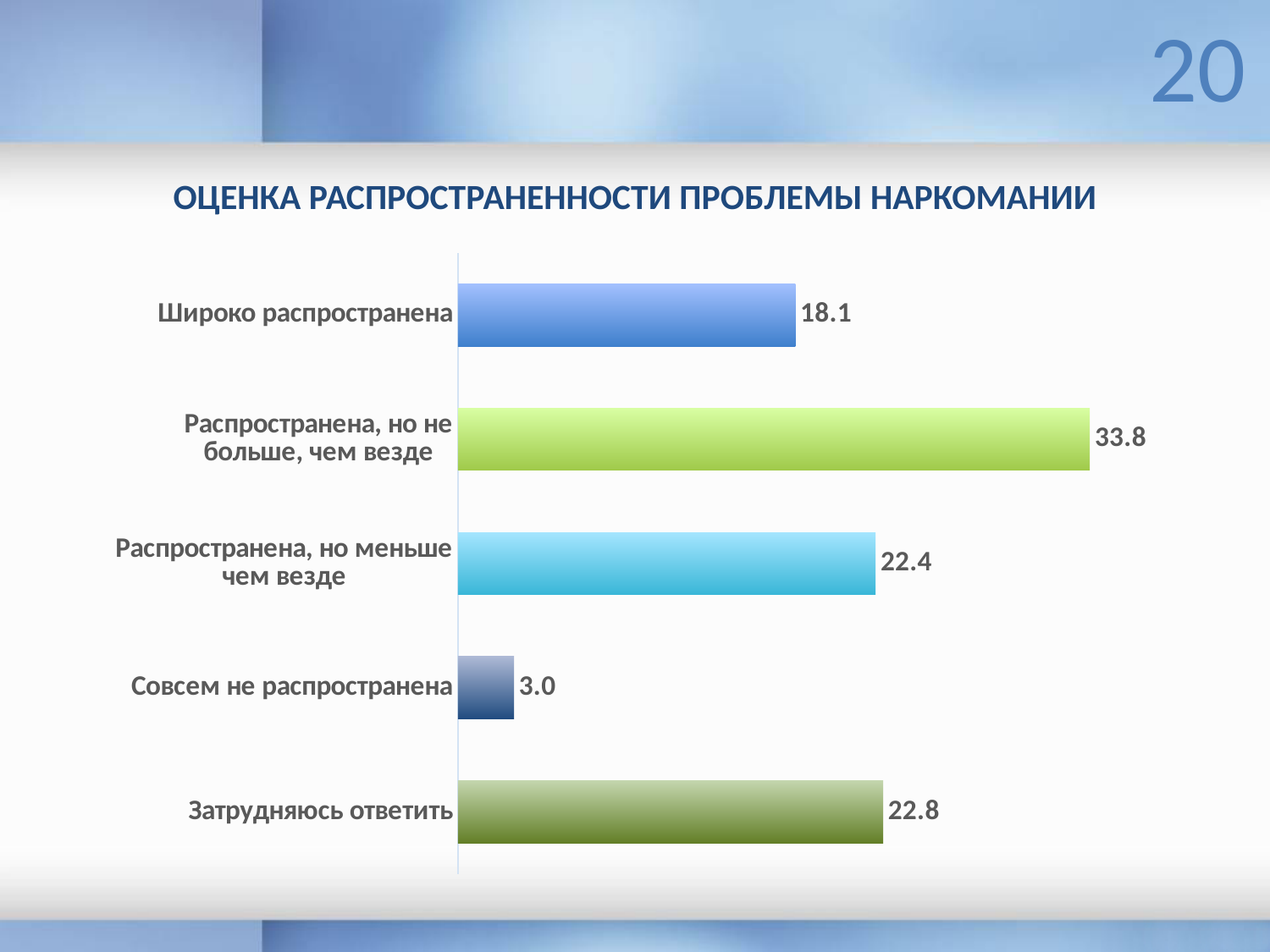
What is the title of the chart? ОЦЕНКА РАСПРОСТРАНЕННОСТИ ПРОБЛЕМЫ НАРКОМАНИИ What is the value for "Затрудняюсь ответить"? 22.8 What is the value for "Широко распространена"? 18.1 What is the value for "Распространена, но не больше, чем везде"? 33.8 What is the difference between the values for "Распространена, но не больше, чем везде" and "Широко распространена"? 15.7 Which category has the highest value? Распространена, но не больше, чем везде What kind of chart is shown on the slide? Bar chart How many categories are shown in the chart? 5 Which is larger: the value for "Широко распространена" or the value for "Распространена, но меньше чем везде"? Распространена, но меньше чем везде What is the difference between the values for "Распространена, но меньше чем везде" and "Совсем не распространена"? 19.4 Which category has the lowest value? Совсем не распространена What is the value for "Совсем не распространена"? 3.0